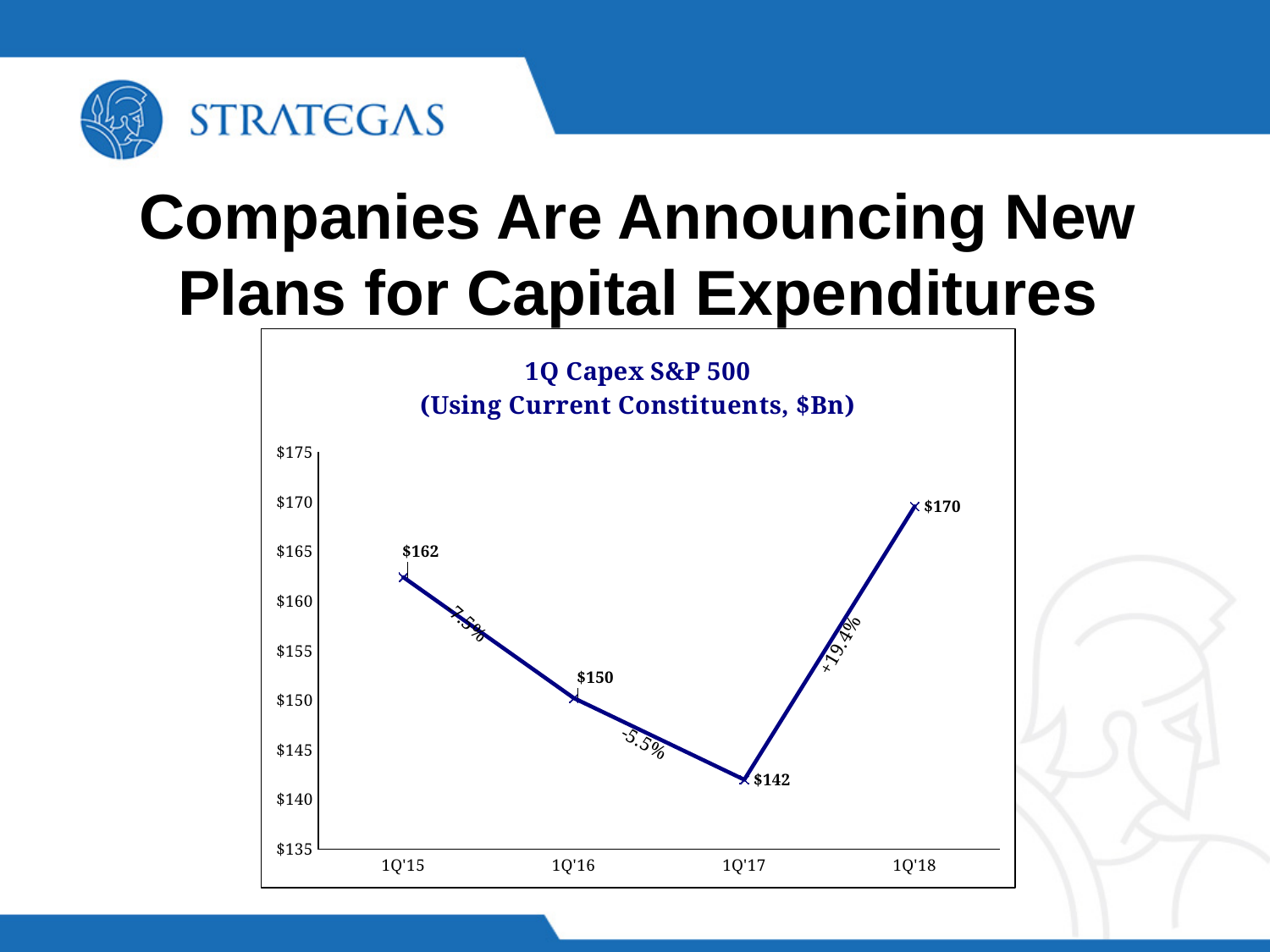
Which is larger, the value for 1Q'15 or the value for 1Q'16? 1Q'15 What percentage change is labelled between 1Q'17 and 1Q'18? +19.4% Is the value for 1Q'16 greater or less than $155? less What is the value for 1Q'18? $170 What is the value for 1Q'15? $162 What kind of chart is shown on the slide? line chart What is the difference between the values for 1Q'18 and 1Q'17? $28 What is the difference between the values for 1Q'15 and 1Q'16? $12 What is the value for 1Q'17? $142 Which quarter has the lowest value? 1Q'17 Which quarter has the highest value? 1Q'18 How many quarters are plotted on the chart? 4